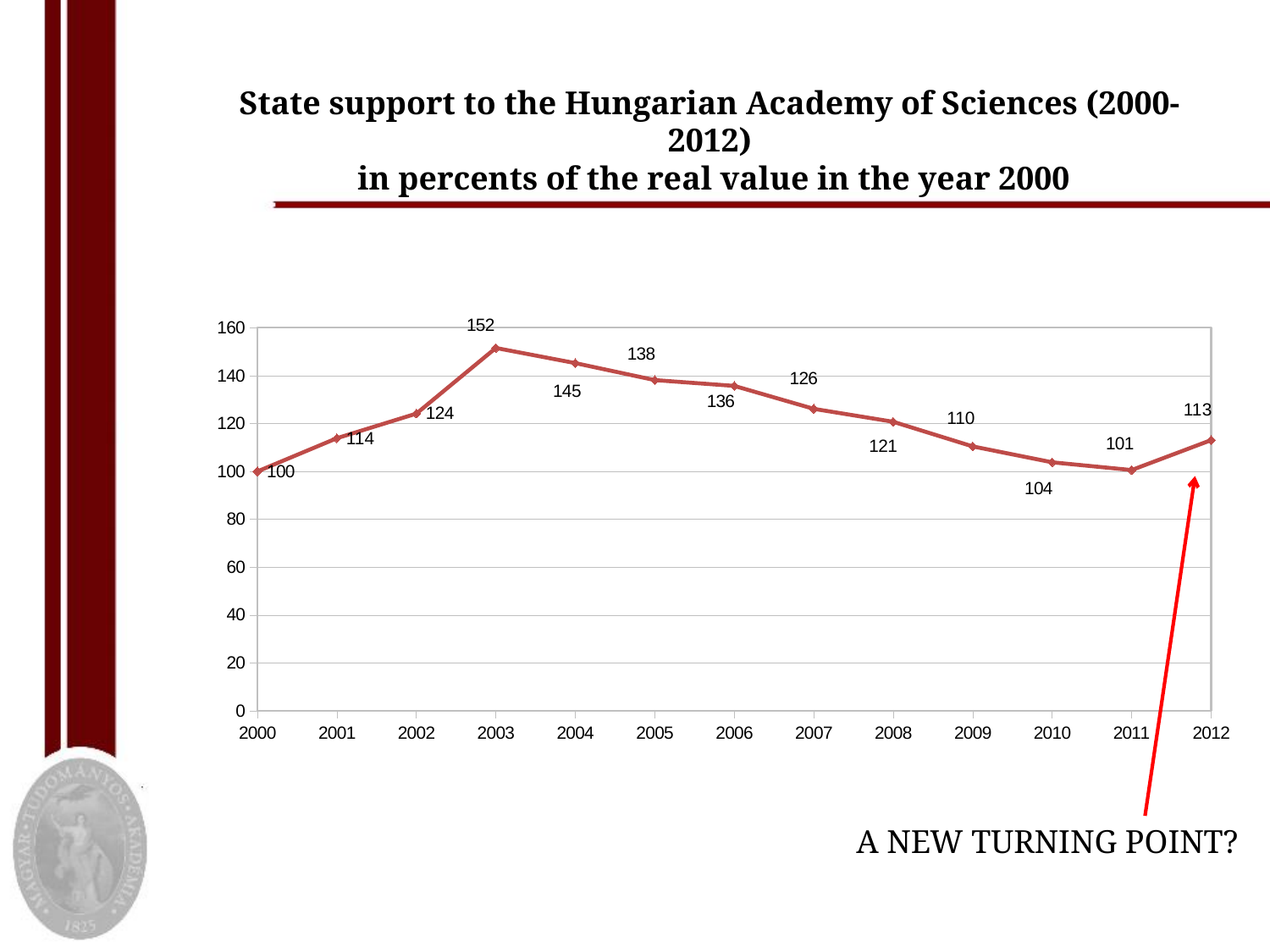
What kind of chart is shown? line chart Which year has the highest value? 2003 What is the difference between the values for 2003 and 2011? 51 Which is larger, the value for 2004 or the value for 2005? 2004 Which year has the lowest value? 2000 What is the value for 2007? 126 What is the value for 2003? 152 Is the value for 2006 greater or less than 120? greater How many years are plotted on the x axis? 13 Do the values rise or fall from 2003 to 2011? fall What is the value for 2011? 101 What text does the red arrow point to the 2011 point with? A NEW TURNING POINT?